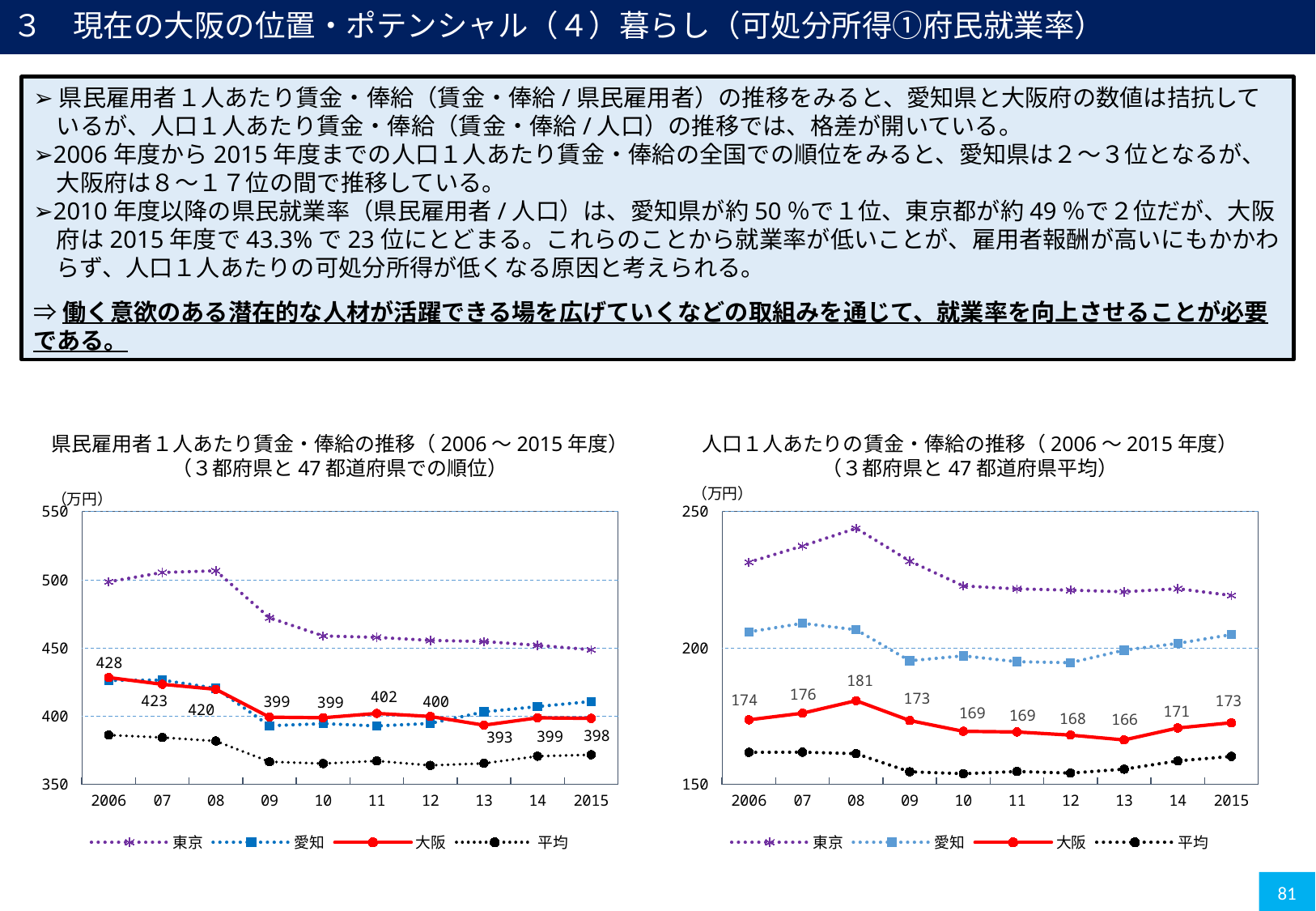
In the right chart (人口１人あたりの賃金・俸給の推移), which is larger for 大阪: the 2007 value or the 2014 value? 2007 In the right chart (人口１人あたりの賃金・俸給の推移), is the value for 東京 in 2008 greater or less than 200? greater In the left chart (県民雇用者１人あたり賃金・俸給の推移), what is the value for 大阪 in 2013? 393 In the right chart (人口１人あたりの賃金・俸給の推移), in which year is the 大阪 value lowest? 2013 In the left chart (県民雇用者１人あたり賃金・俸給の推移), how many series does the legend list? 4 In the right chart (人口１人あたりの賃金・俸給の推移), how many years are plotted on the x axis? 10 In the left chart (県民雇用者１人あたり賃金・俸給の推移), what is the difference between the 大阪 values for 2006 and 2015? 30 In the left chart (県民雇用者１人あたり賃金・俸給の推移), what is the value for 大阪 in 2006? 428 In the right chart (人口１人あたりの賃金・俸給の推移), what is the value for 大阪 in 2008? 181 What type of chart is the right chart (人口１人あたりの賃金・俸給の推移)? line chart In the left chart (県民雇用者１人あたり賃金・俸給の推移), in which year is the 大阪 value highest? 2006 In the left chart (県民雇用者１人あたり賃金・俸給の推移), is the value for 東京 in 2006 greater or less than 450? greater